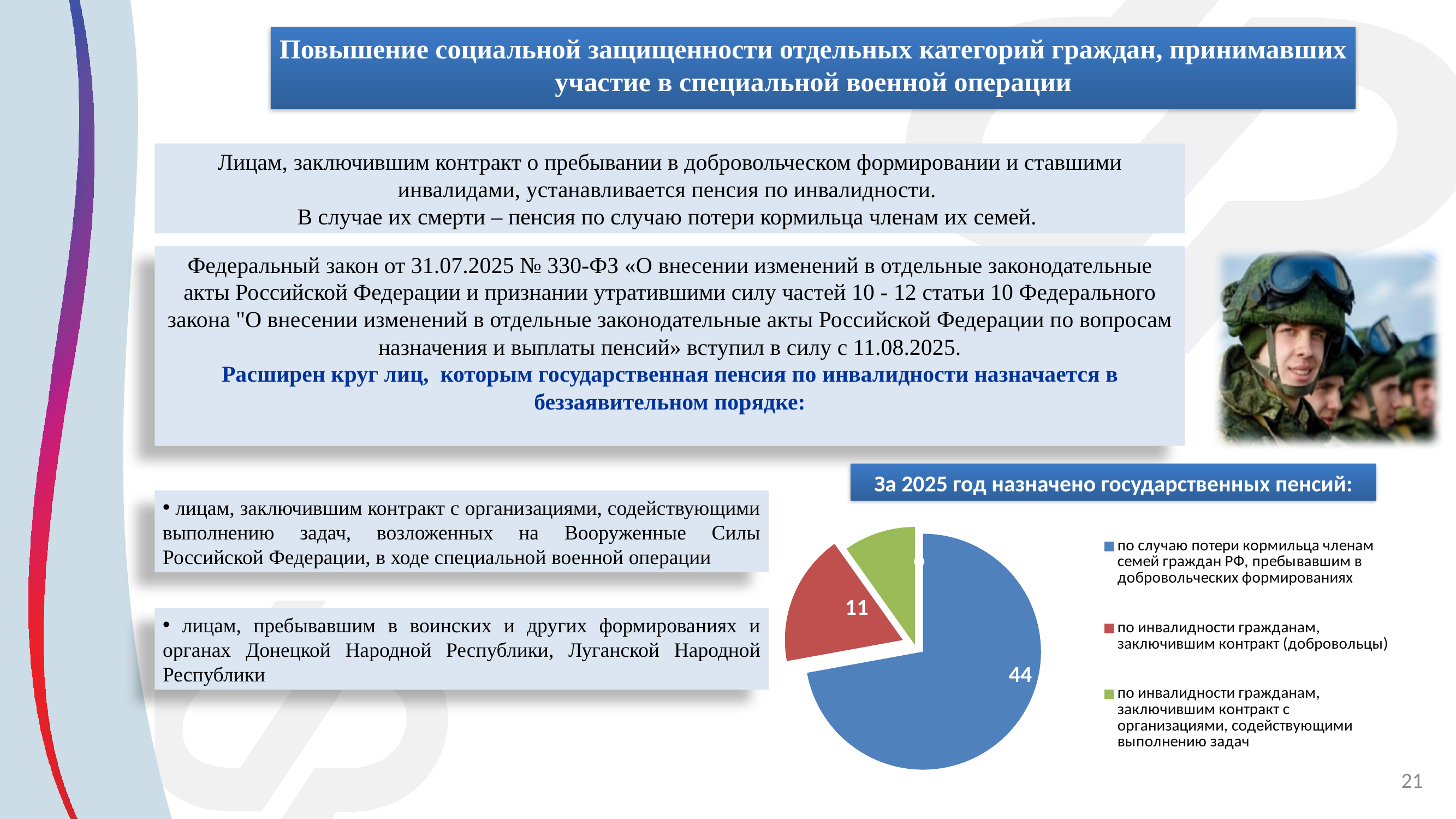
What colour is the slice for "по инвалидности гражданам, заключившим контракт (добровольцы)"? red Which is larger: the slice for "по случаю потери кормильца членам семей граждан РФ, пребывавшим в добровольческих формированиях" or the slice for "по инвалидности гражданам, заключившим контракт (добровольцы)"? по случаю потери кормильца членам семей граждан РФ, пребывавшим в добровольческих формированиях What is the value for "по случаю потери кормильца членам семей граждан РФ, пребывавшим в добровольческих формированиях"? 44 Which category has the smallest slice of the pie? по инвалидности гражданам, заключившим контракт с организациями, содействующими выполнению задач What kind of chart is shown on the slide? pie chart Which is larger: the slice for "по инвалидности гражданам, заключившим контракт (добровольцы)" or the slice for "по инвалидности гражданам, заключившим контракт с организациями, содействующими выполнению задач"? по инвалидности гражданам, заключившим контракт (добровольцы) What is the value for "по инвалидности гражданам, заключившим контракт (добровольцы)"? 11 What is the difference between the value for "по случаю потери кормильца членам семей граждан РФ, пребывавшим в добровольческих формированиях" and the value for "по инвалидности гражданам, заключившим контракт (добровольцы)"? 33 How many slices does the pie chart have? 3 What is the chart's title? За 2025 год назначено государственных пенсий: How many entries does the legend of the pie chart list? 3 Which category has the largest slice of the pie? по случаю потери кормильца членам семей граждан РФ, пребывавшим в добровольческих формированиях